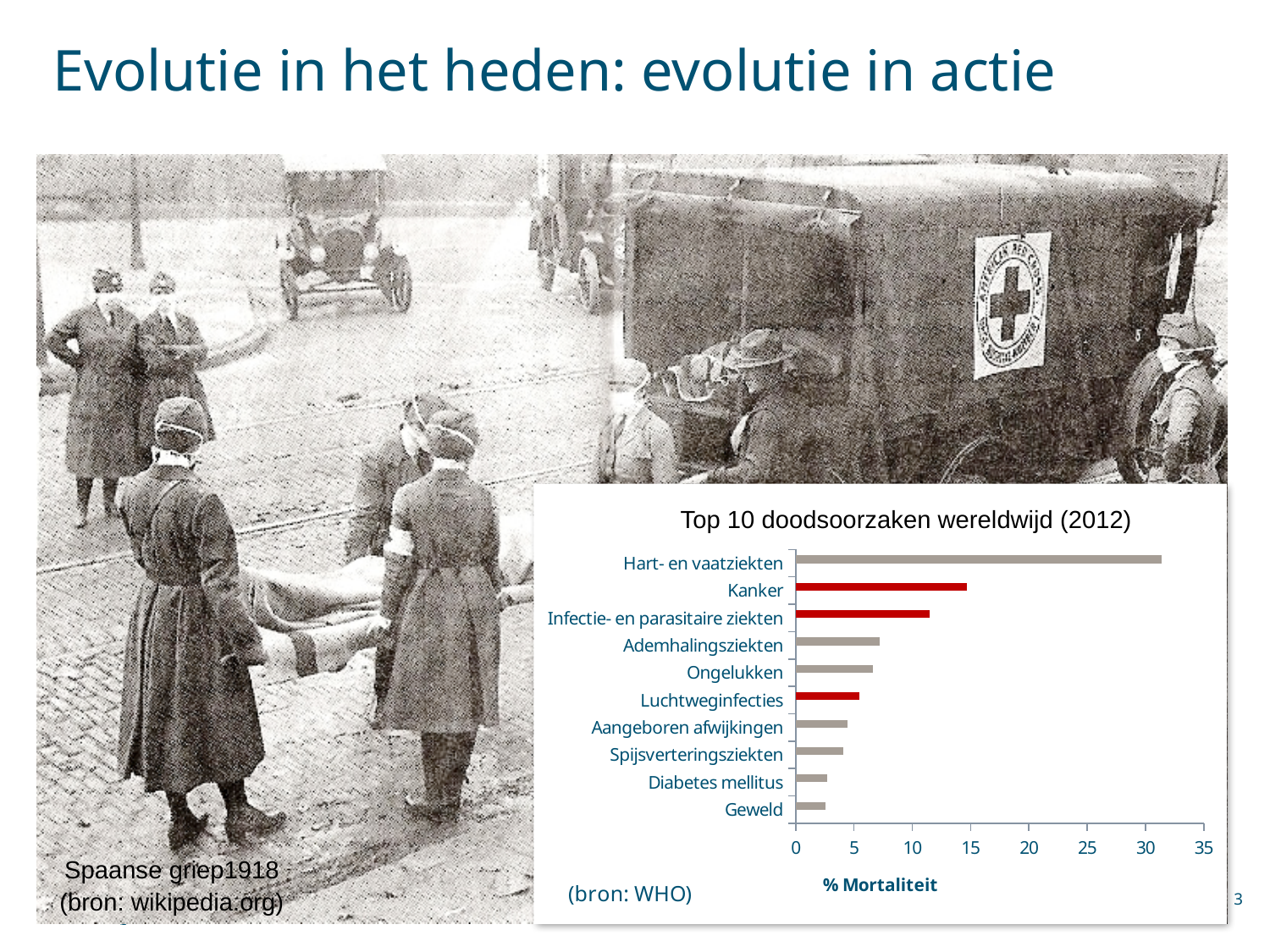
What is the title of the chart? Top 10 doodsoorzaken wereldwijd (2012) Is the value for Hart- en vaatziekten greater or less than 30? greater Which has a higher % Mortaliteit, Kanker or Infectie- en parasitaire ziekten? Kanker How many causes of death are listed in the chart? 10 Which has a higher % Mortaliteit, Luchtweginfecties or Geweld? Luchtweginfecties Is the value for Kanker greater or less than 10? greater Which cause of death has the highest % Mortaliteit in the chart? Hart- en vaatziekten Is the value for Infectie- en parasitaire ziekten greater or less than 15? less What kind of chart is shown on the slide? bar chart What is the label of the horizontal axis of the chart? % Mortaliteit